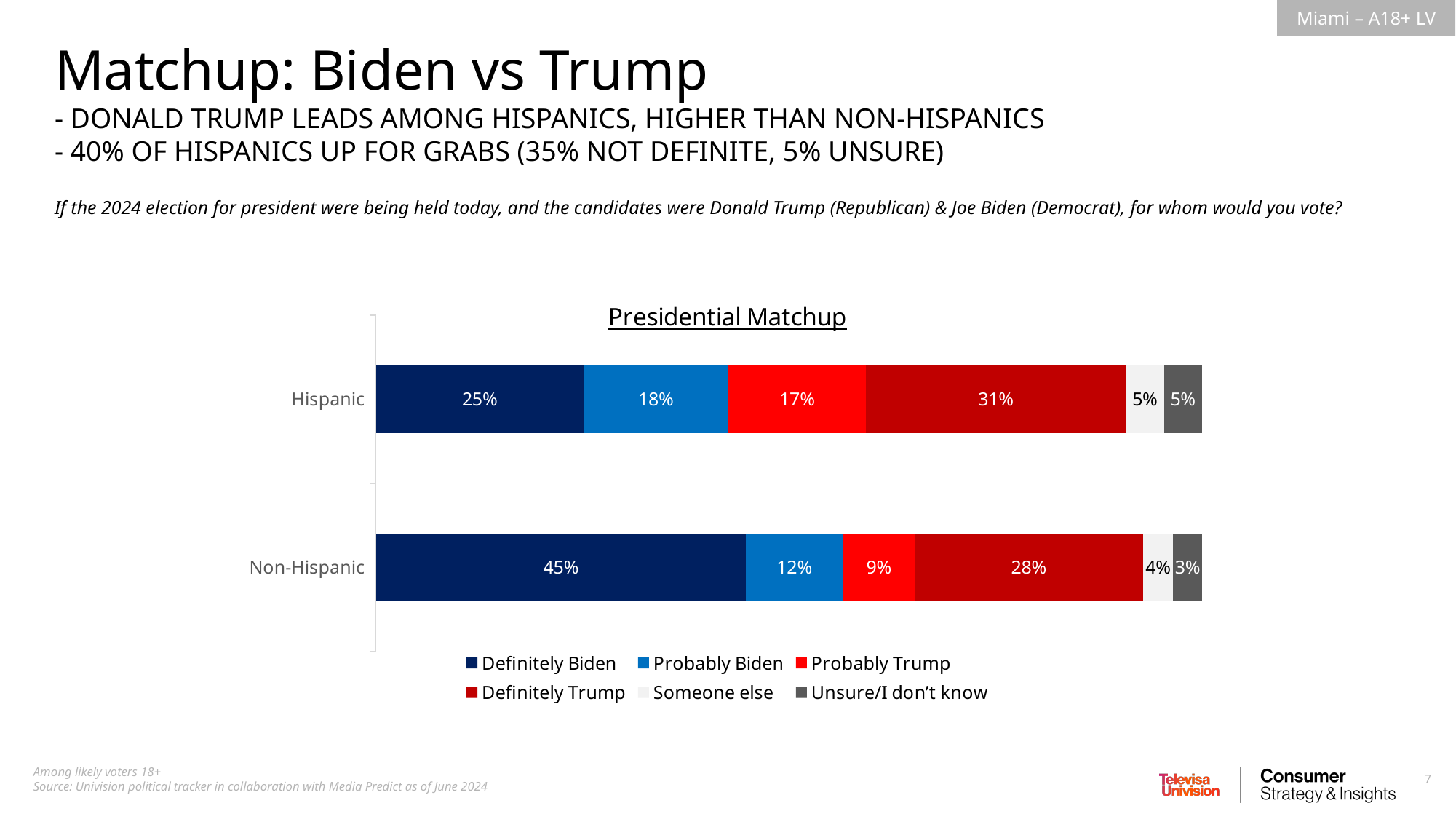
What percentage of Hispanic respondents said Probably Biden? 18% Which category has the higher Definitely Biden share, Hispanic or Non-Hispanic? Non-Hispanic What kind of chart is shown on the slide? Stacked bar chart How many series does the legend list? 6 What percentage of Non-Hispanic respondents said Definitely Biden? 45% What is the difference between the Definitely Trump share for Hispanic and Non-Hispanic respondents? 3 percentage points What percentage of Non-Hispanic respondents said Probably Trump? 9% What is the difference between the Definitely Biden share for Non-Hispanic and Hispanic respondents? 20 percentage points Which response has the largest share among Hispanic respondents? Definitely Trump What percentage of Hispanic respondents said Definitely Trump? 31% How many categories are shown on the chart? 2 What is the title of the chart? Presidential Matchup